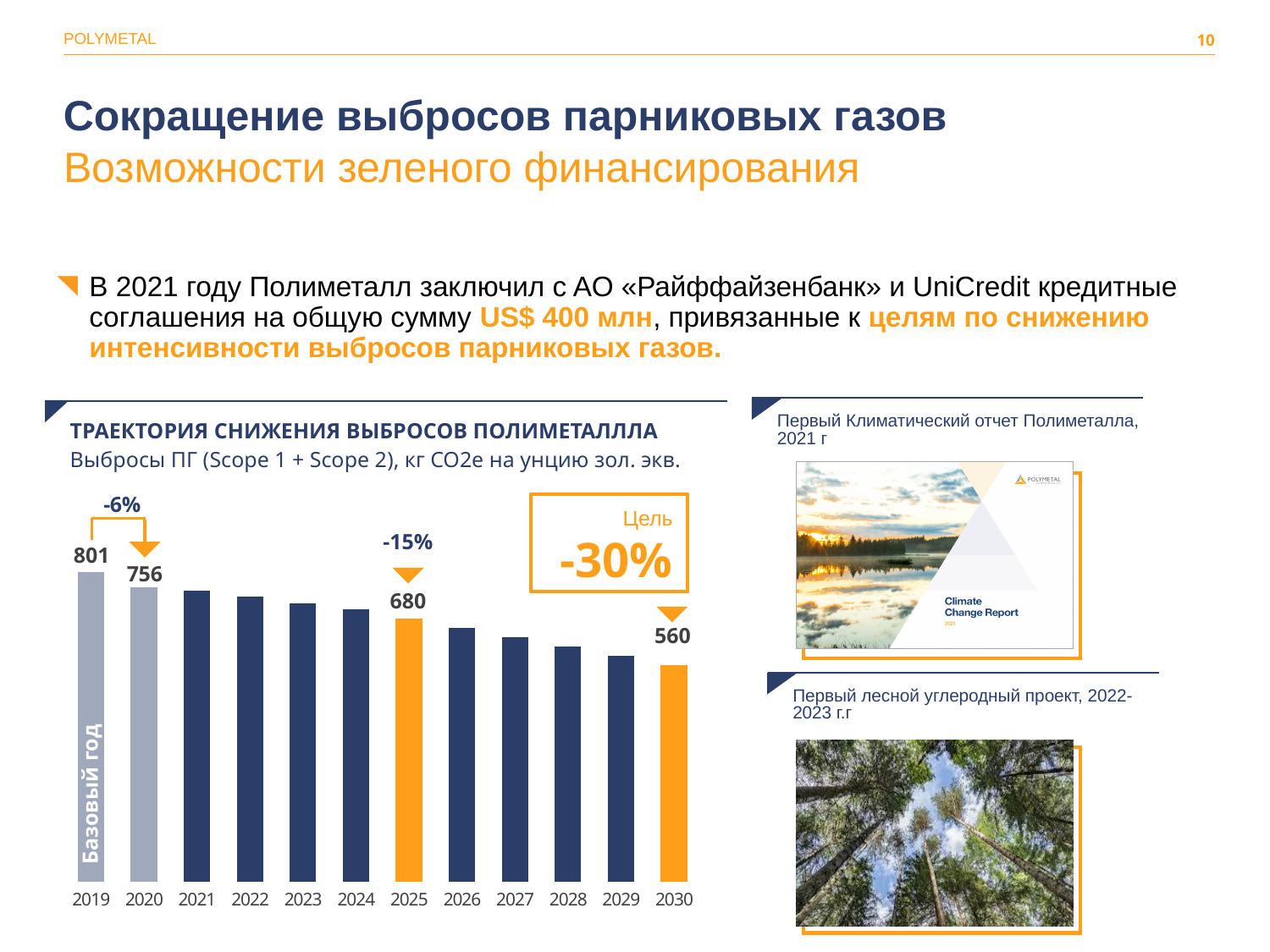
Which is larger in the emissions trajectory chart, the value for 2020 or the value for 2025? 2020 What is the difference between the values for 2019 and 2020 in the emissions trajectory chart? 45 What is the difference between the values for 2025 and 2030 in the emissions trajectory chart? 120 What is the value for 2030 in the emissions trajectory chart? 560 How many years are shown on the x axis of the emissions trajectory chart? 12 What is the value for 2020 in the emissions trajectory chart? 756 What kind of chart is the emissions trajectory chart? bar chart Which year has the highest value in the emissions trajectory chart? 2019 Do the values in the emissions trajectory chart rise or fall from 2019 to 2030? fall What is the value for 2025 in the emissions trajectory chart? 680 Which year has the lowest value in the emissions trajectory chart? 2030 What is the value for 2019 in the emissions trajectory chart? 801